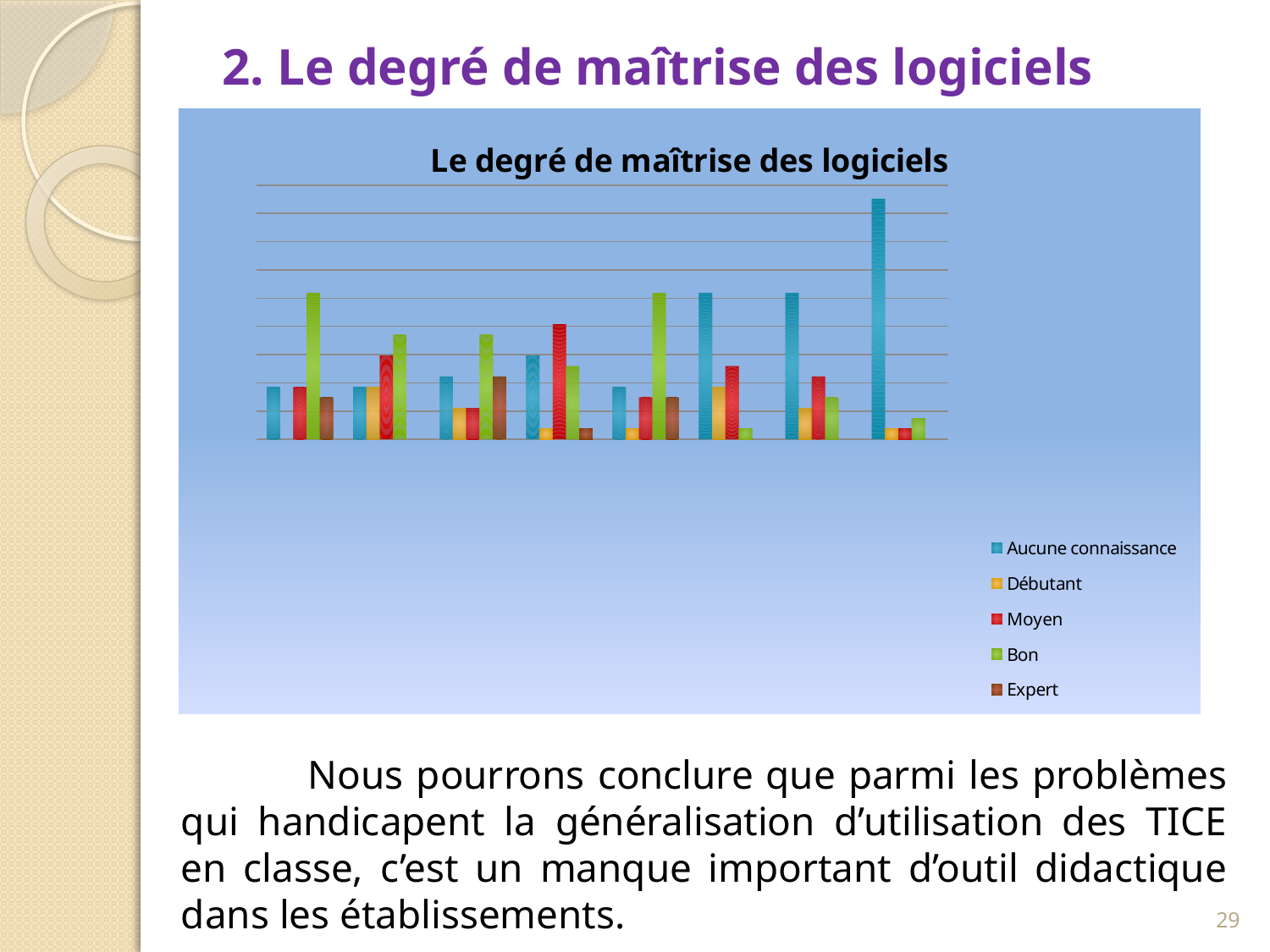
What is the title of the chart? Le degré de maîtrise des logiciels What kind of chart is shown on the slide? bar chart How many groups of bars are plotted in the chart? 8 How many series does the chart legend list? 5 Which series has the single tallest bar in the chart? Aucune connaissance Which series is shown in green in the chart legend? Bon